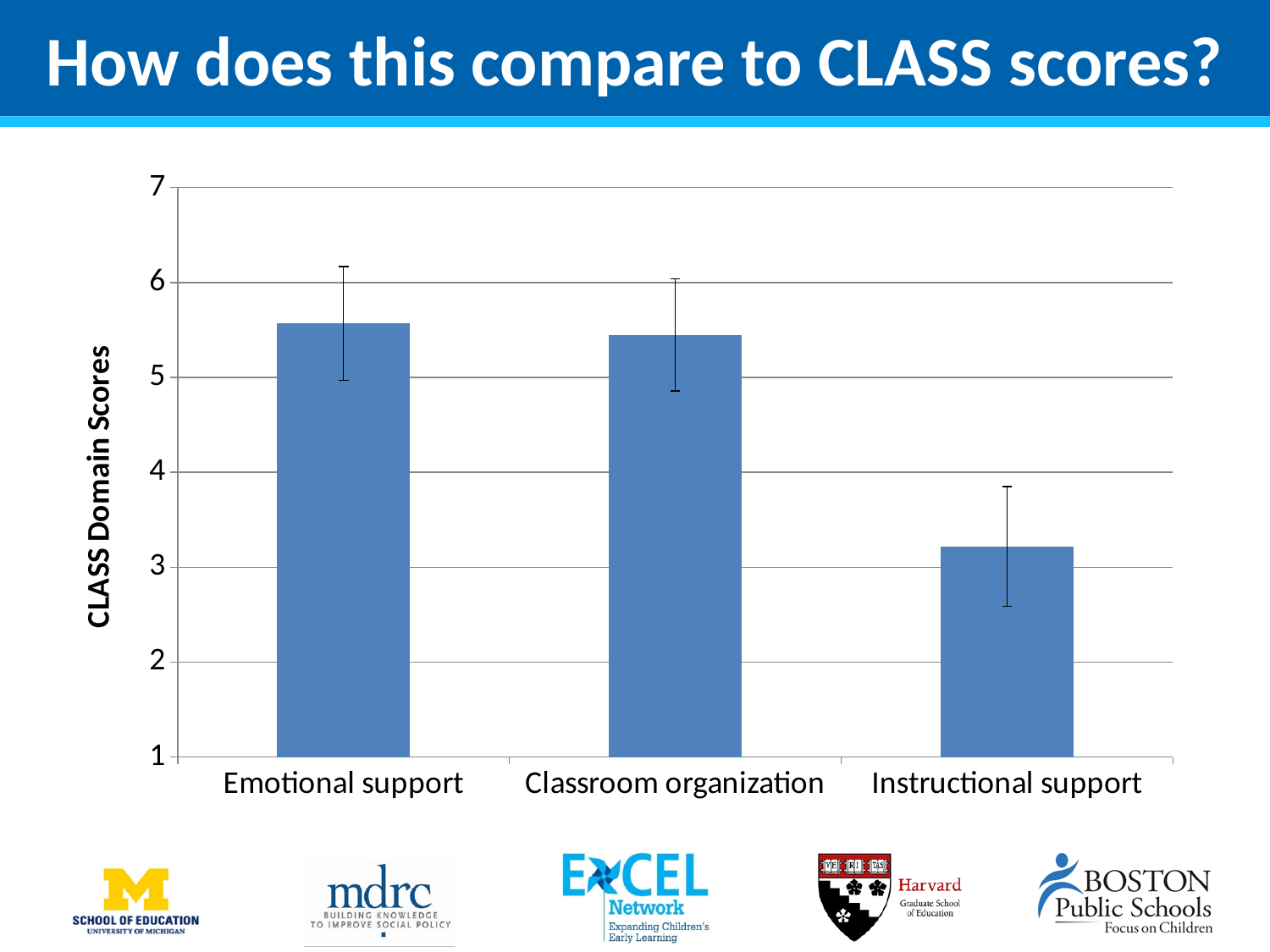
Is the value for Classroom organization greater or less than 5? greater Is the value for Emotional support greater or less than 6? less Is the value for Instructional support greater or less than 4? less What kind of chart is shown on the slide? bar chart Which category has the lowest CLASS domain score? Instructional support What is the title of the y axis? CLASS Domain Scores Which is larger, the value for Classroom organization or the value for Instructional support? Classroom organization How many categories are plotted on the x axis? 3 Which is larger, the value for Emotional support or the value for Instructional support? Emotional support What is the title of the slide? How does this compare to CLASS scores?